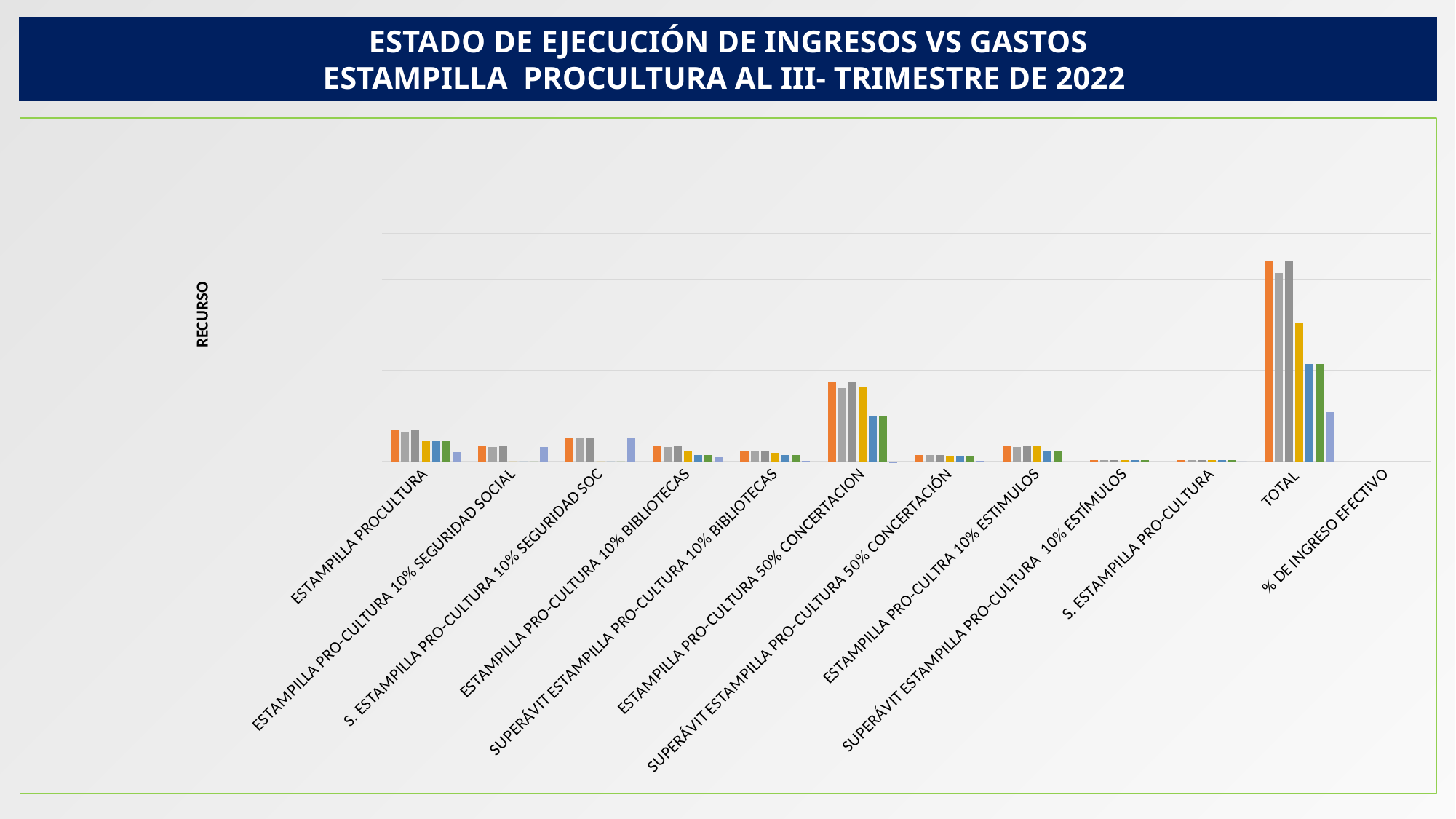
Which has taller bars: ESTAMPILLA PROCULTURA or SUPERÁVIT ESTAMPILLA PRO-CULTURA 10% ESTÍMULOS? ESTAMPILLA PROCULTURA Excluding TOTAL, which category has the tallest bars? ESTAMPILLA PRO-CULTURA 50% CONCERTACION Which has taller bars: ESTAMPILLA PRO-CULTURA 50% CONCERTACION or ESTAMPILLA PROCULTURA? ESTAMPILLA PRO-CULTURA 50% CONCERTACION How many categories are shown along the x axis of the chart? 12 What kind of chart is shown on the slide? bar chart Which category has the tallest bars in the chart? TOTAL What is the label on the vertical axis of the chart? RECURSO Which has taller bars: TOTAL or ESTAMPILLA PRO-CULTURA 10% ESTIMULOS? TOTAL What is the title shown above the chart? ESTADO DE EJECUCIÓN DE INGRESOS VS GASTOS ESTAMPILLA PROCULTURA AL III- TRIMESTRE DE 2022 What is the last category on the x axis of the chart? % DE INGRESO EFECTIVO